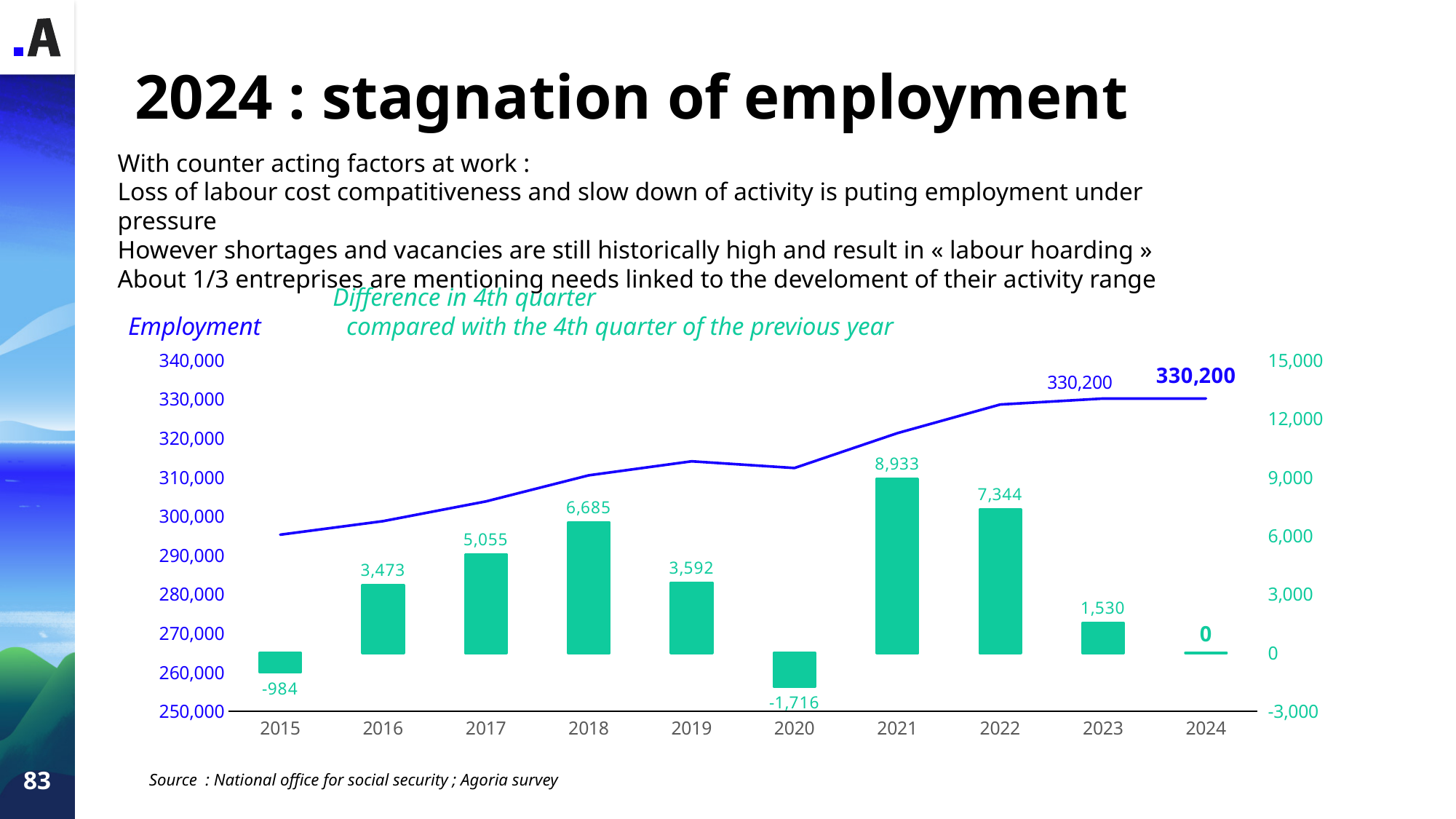
Which year has the lowest 'Difference in 4th quarter' bar? 2020 What is the value of the 'Difference in 4th quarter' bar for 2020? -1,716 What is the value of the 'Difference in 4th quarter' bar for 2024? 0 What colour are the 'Difference in 4th quarter' bars on the chart? Green What is the Employment value shown for 2024? 330,200 Which year has the highest 'Difference in 4th quarter' bar? 2021 Does the Employment line rise or fall between 2015 and 2022? rise How many years are shown on the x axis of the chart? 10 What is the difference between the 2021 bar value (8,933) and the 2022 bar value (7,344)? 1,589 Which is larger, the 'Difference in 4th quarter' bar for 2017 or for 2019? 2017 What is the value of the 'Difference in 4th quarter' bar for 2021? 8,933 Is the Employment line value for 2015 greater or less than 300,000? less